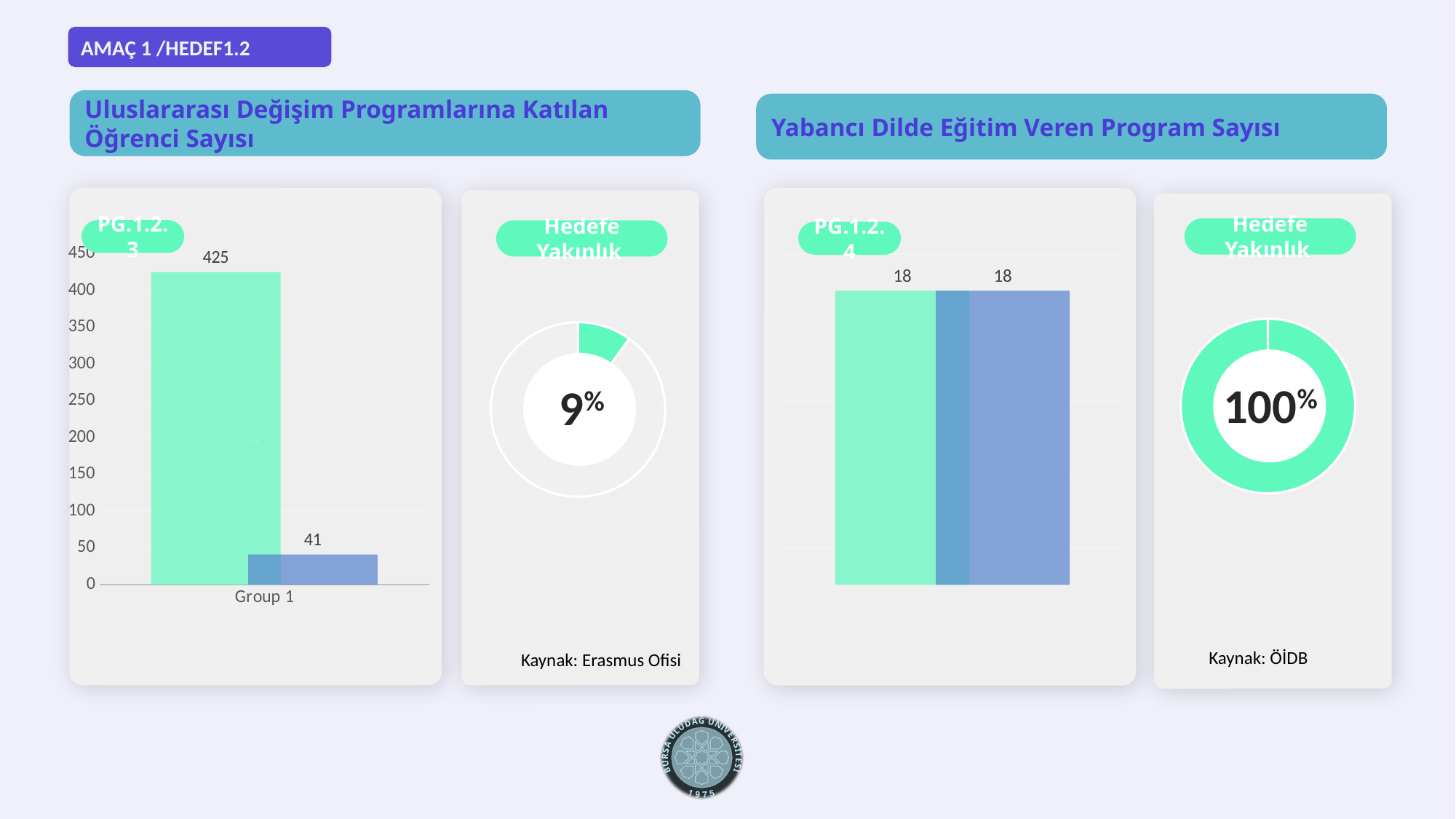
In the bar chart under 'Uluslararası Değişim Programlarına Katılan Öğrenci Sayısı', what is the value of the green bar? 425 In the bar chart under 'Uluslararası Değişim Programlarına Katılan Öğrenci Sayısı', what is the category label on the x axis? Group 1 In the bar chart under 'Uluslararası Değişim Programlarına Katılan Öğrenci Sayısı', what is the value of the blue bar? 41 In the bar chart under 'Uluslararası Değişim Programlarına Katılan Öğrenci Sayısı', which bar is larger, the green one or the blue one? the green one In the bar chart under 'Yabancı Dilde Eğitim Veren Program Sayısı', what is the value of the blue bar? 18 In the bar chart under 'Uluslararası Değişim Programlarına Katılan Öğrenci Sayısı', what is the difference between the green bar and the blue bar? 384 What kind of chart is shown under 'Yabancı Dilde Eğitim Veren Program Sayısı' on the left side of that section? bar chart What percentage is shown in the 'Hedefe Yakınlık' gauge next to the 'Yabancı Dilde Eğitim Veren Program Sayısı' chart? 100% In the bar chart under 'Yabancı Dilde Eğitim Veren Program Sayısı', what is the difference between the green bar and the blue bar? 0 In the bar chart under 'Uluslararası Değişim Programlarına Katılan Öğrenci Sayısı', what is the highest value shown on the y axis? 450 In the bar chart under 'Yabancı Dilde Eğitim Veren Program Sayısı', what is the value of the green bar? 18 What percentage is shown in the 'Hedefe Yakınlık' gauge next to the 'Uluslararası Değişim Programlarına Katılan Öğrenci Sayısı' chart? 9%